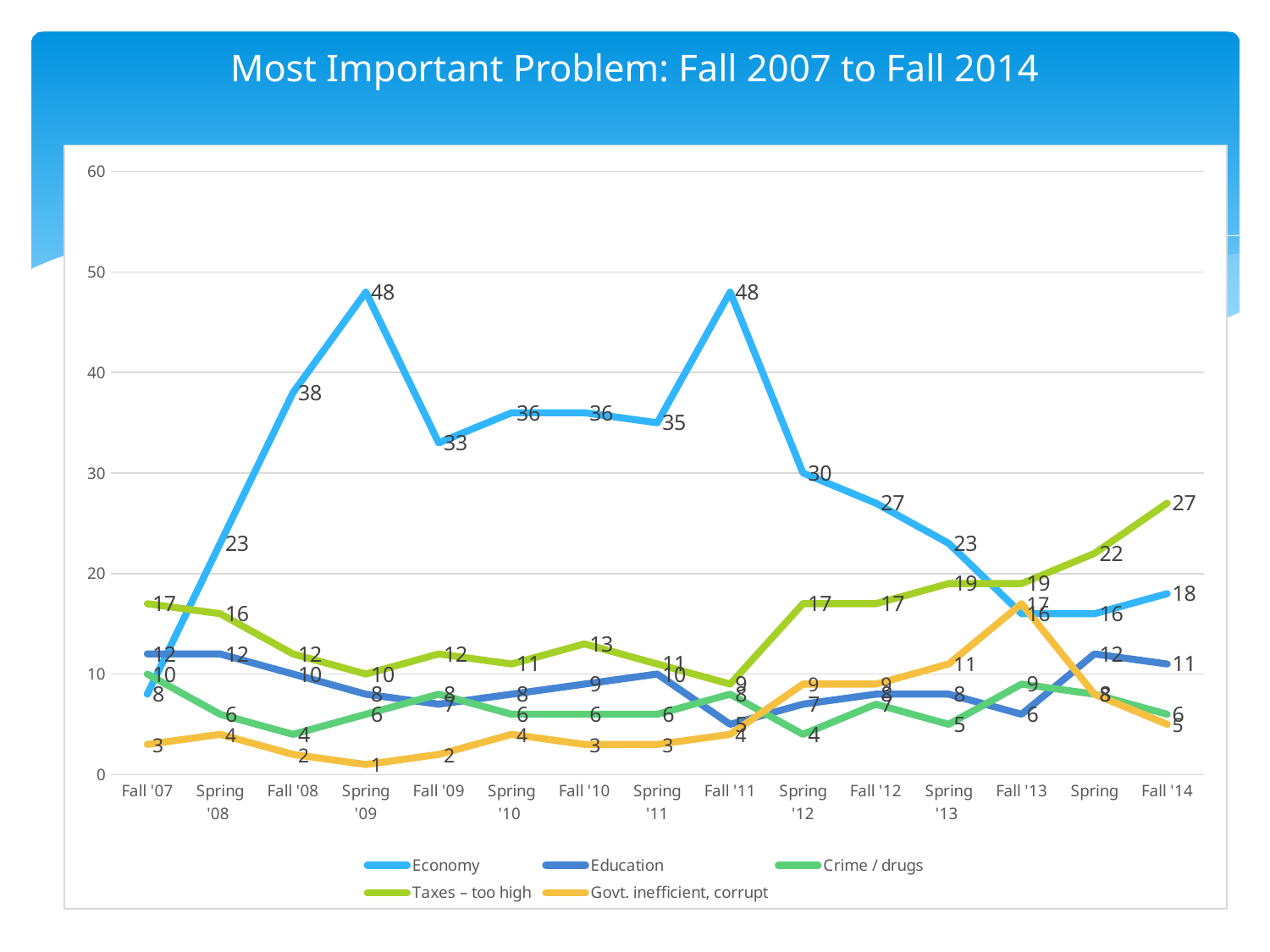
Is the value for Economy in Fall '11 greater or less than 40? greater In which period does Govt. inefficient, corrupt reach its lowest value? Spring '09 How many survey periods are plotted along the x axis? 15 In Fall '14, which is larger: Taxes – too high or Economy? Taxes – too high What is the difference between the Economy values in Spring '09 and Fall '09? 15 What is the value for Economy in Fall '08? 38 What is the value for Govt. inefficient, corrupt in Fall '13? 17 What is the value for Taxes – too high in Fall '14? 27 What is the highest value reached by the Economy series? 48 What kind of chart is shown on the slide? line chart How many series does the legend list? 5 Does the Economy series rise or fall from Fall '11 to Fall '13? fall